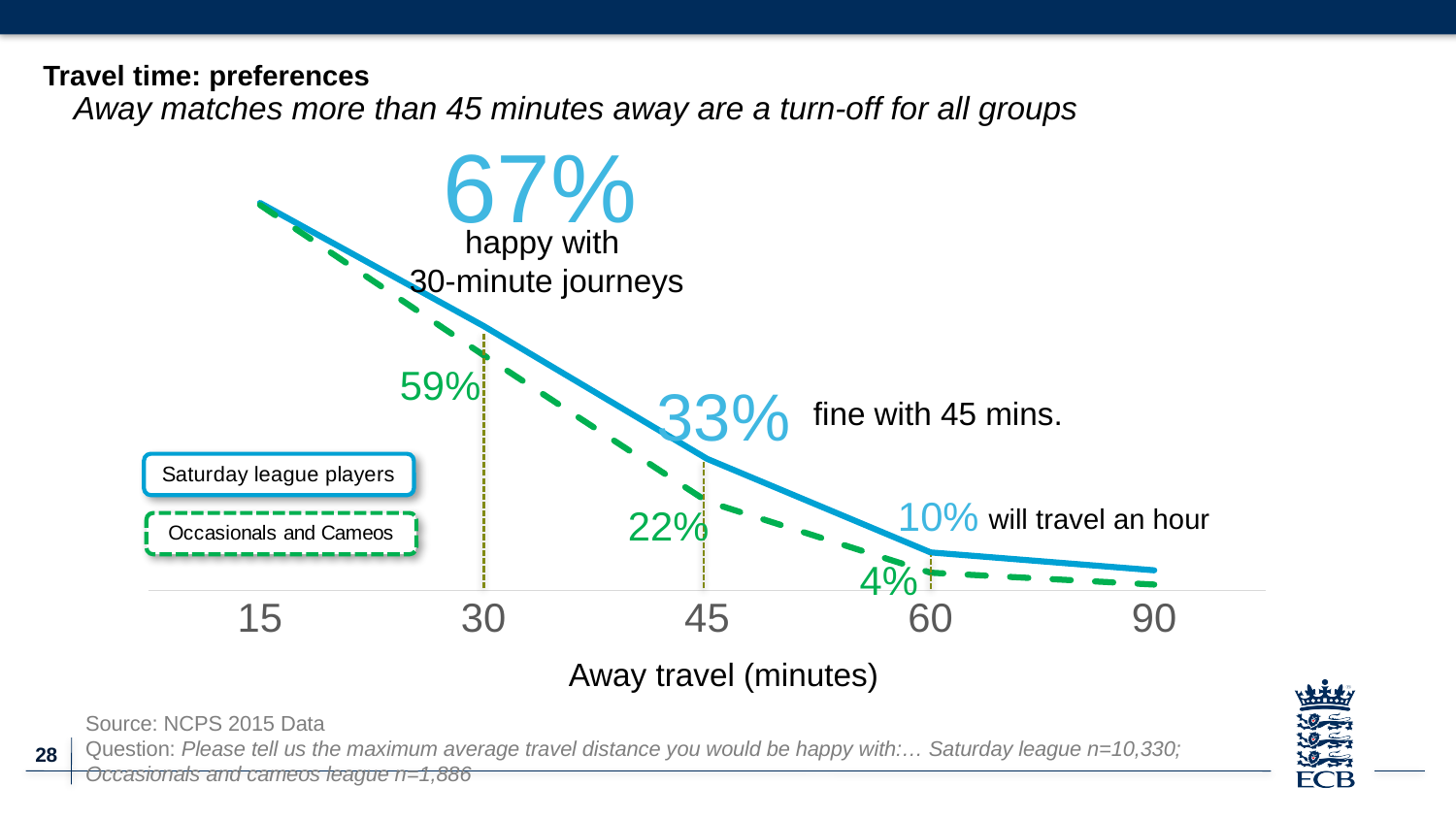
Do the values rise or fall as away travel time increases along the x axis? Fall What is the difference between the Saturday league players and Occasionals and Cameos values at 45 minutes? 11 percentage points What is the difference between the two series at 30 minutes? 8 percentage points What percentage of Saturday league players are fine with 45 minutes of away travel? 33% What is the value for Occasionals and Cameos at 45 minutes? 22% What percentage of Saturday league players will travel an hour? 10% What percentage of Occasionals and Cameos are happy with 30-minute journeys? 59% What percentage of Saturday league players are happy with 30-minute journeys? 67% How many series does the legend list? 2 What is the value for Occasionals and Cameos at 60 minutes? 4% What kind of chart is shown on the slide? Line chart At 60 minutes, which series has the higher value: Saturday league players or Occasionals and Cameos? Saturday league players